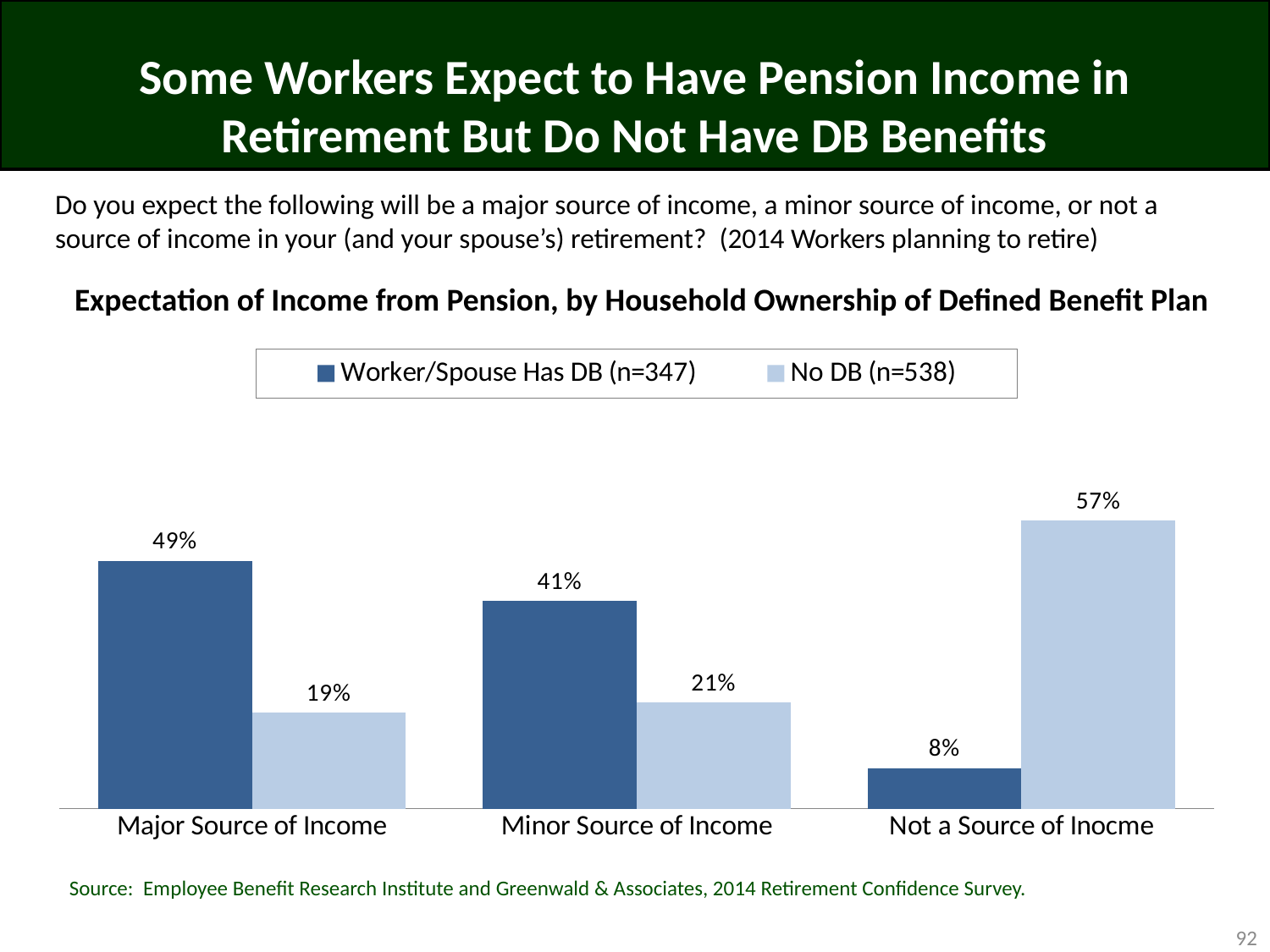
Which category has the lowest value for the Worker/Spouse Has DB series? Not a Source of Income What is the difference between the Worker/Spouse Has DB and No DB values in the Major Source of Income category? 30 percentage points What is the value for No DB in the Not a Source of Income category? 57% How many series does the legend list? 2 What is the value for Worker/Spouse Has DB in the Minor Source of Income category? 41% What is the value for No DB in the Major Source of Income category? 19% What percentage of workers whose household has a DB plan expect pension to be a major source of income? 49% What is the sample size (n) for the No DB series shown in the legend? 538 In the Minor Source of Income category, which series has the larger value? Worker/Spouse Has DB What kind of chart is shown on the slide? Bar chart How many categories are shown on the x axis? 3 Which category has the highest value for the No DB series? Not a Source of Income